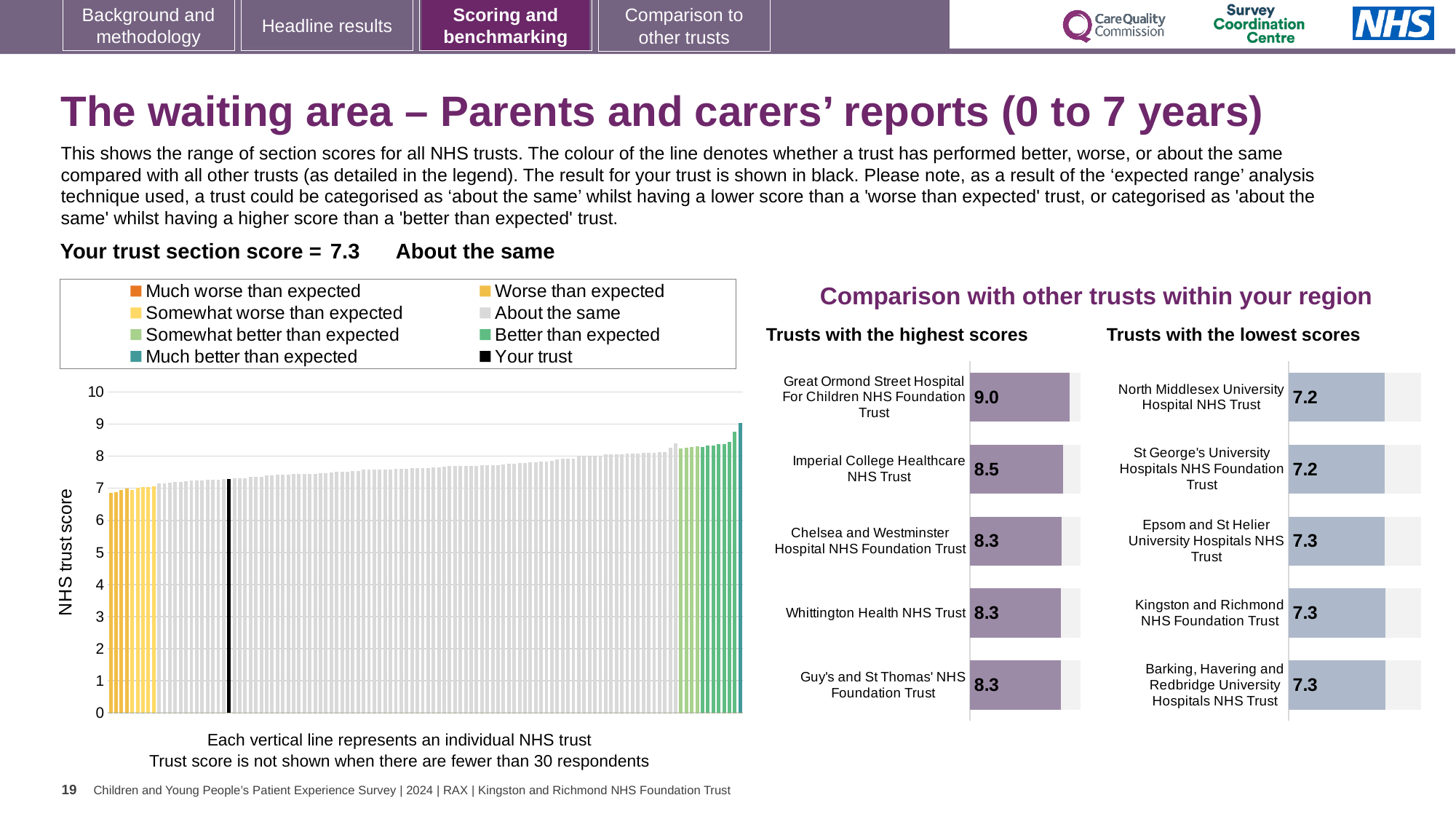
How many entries does the legend of the main NHS trust score chart list? 8 In the main NHS trust score chart on the left, what kind of chart is it? Bar chart In the main NHS trust score chart on the left, do the values rise or fall from left to right along the x axis? Rise In the 'Trusts with the lowest scores' chart, what is the score for North Middlesex University Hospital NHS Trust? 7.2 In the 'Trusts with the highest scores' chart, what is the score for Great Ormond Street Hospital For Children NHS Foundation Trust? 9.0 In the main NHS trust score chart on the left, is the value for the black 'Your trust' bar greater or less than 8? less How many trusts are shown in the 'Trusts with the lowest scores' chart? 5 In the 'Trusts with the highest scores' chart, what is the score for Imperial College Healthcare NHS Trust? 8.5 In the 'Trusts with the lowest scores' chart, what is the score for Kingston and Richmond NHS Foundation Trust? 7.3 In the 'Trusts with the highest scores' chart, which has the larger score: Imperial College Healthcare NHS Trust or Whittington Health NHS Trust? Imperial College Healthcare NHS Trust In the 'Trusts with the highest scores' chart, what is the difference between the scores of Great Ormond Street Hospital For Children NHS Foundation Trust and Imperial College Healthcare NHS Trust? 0.5 In the 'Trusts with the highest scores' chart, which trust has the highest score? Great Ormond Street Hospital For Children NHS Foundation Trust